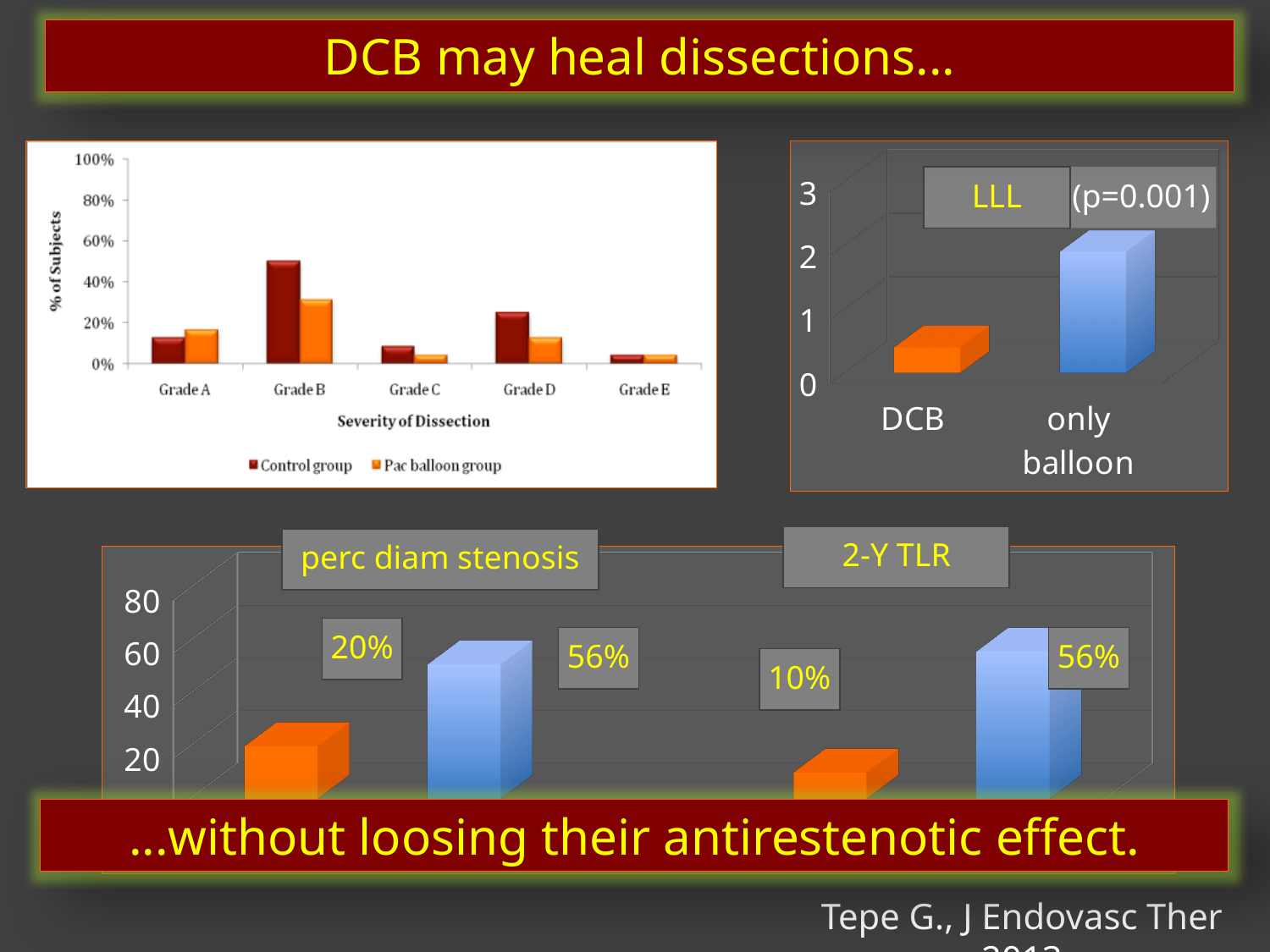
In the bottom chart, what is the difference between the two labelled values under '2-Y TLR'? 46% In the bottom chart, what is the value labelled on the orange bar under 'perc diam stenosis'? 20% In the top-left 'Severity of Dissection' chart, for Grade D, which series has the larger value, Control group or Pac balloon group? Control group In the top-right LLL chart, is the value for DCB greater or less than 1? less In the top-left chart, what are the two legend entries? Control group, Pac balloon group In the top-right LLL chart, which category has the larger value, DCB or only balloon? only balloon In the top-left 'Severity of Dissection' chart, is the Control group value for Grade B greater or less than 40%? greater In the top-left 'Severity of Dissection' chart, which grade has the highest value for the Control group? Grade B In the top-left 'Severity of Dissection' chart, how many series does the legend list? 2 In the top-left 'Severity of Dissection' chart, how many grade categories are shown on the x axis? 5 What kind of chart is the top-left chart titled 'Severity of Dissection'? bar chart In the top-left 'Severity of Dissection' chart, is the Pac balloon group value for Grade B greater or less than 40%? less